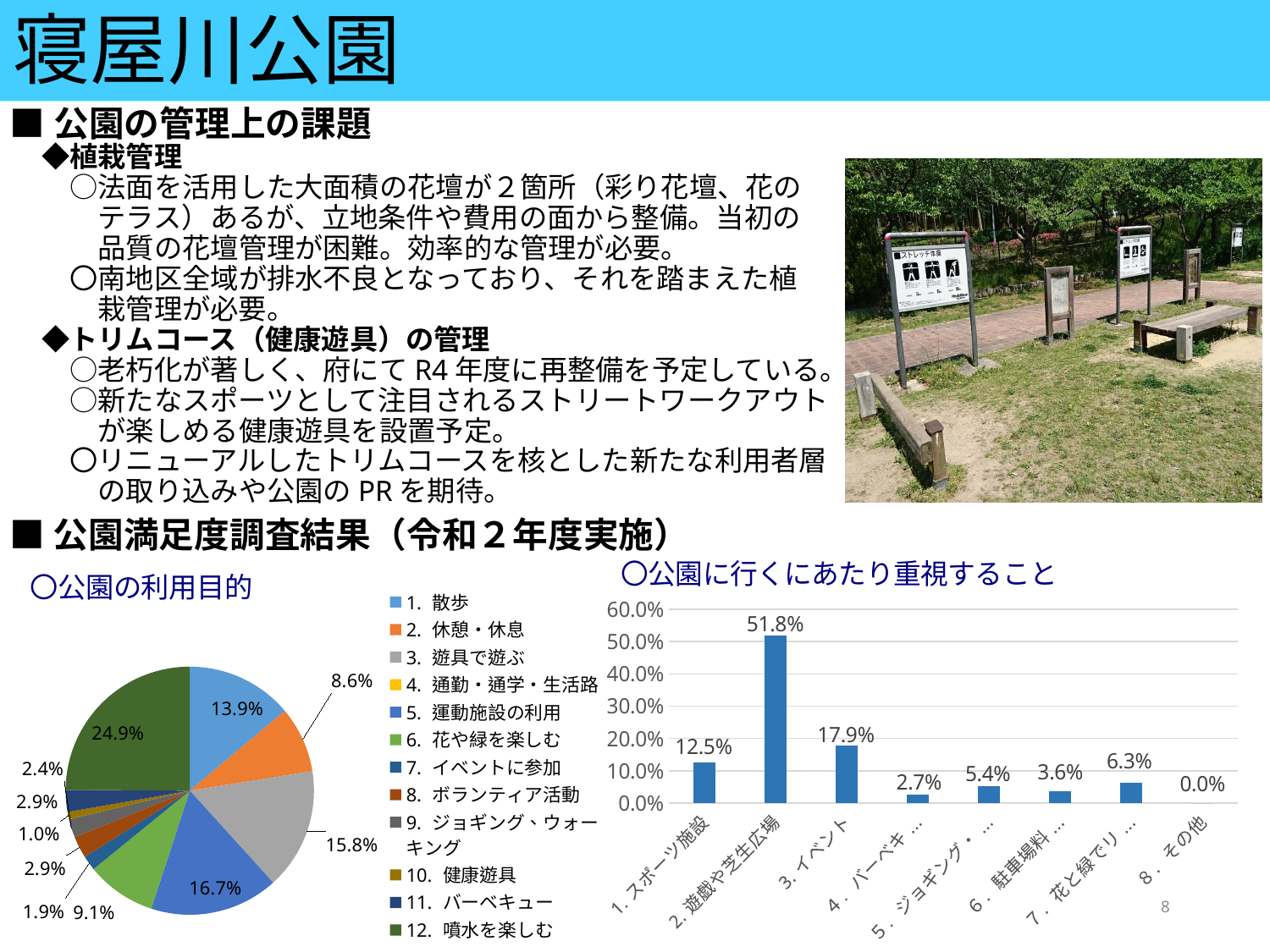
What kind of chart is the chart titled 公園の利用目的? pie chart In the bar chart titled 公園に行くにあたり重視すること, what is the difference between the values for 2. 遊戯や芝生広場 and 3. イベント? 33.9% In the pie chart titled 公園の利用目的, which is larger, the slice for 1. 散歩 or the slice for 2. 休憩・休息? 1. 散歩 How many entries does the legend of the pie chart titled 公園の利用目的 list? 12 In the bar chart titled 公園に行くにあたり重視すること, which category has the highest value? 2. 遊戯や芝生広場 In the bar chart titled 公園に行くにあたり重視すること, what is the value for 1. スポーツ施設? 12.5% In the bar chart titled 公園に行くにあたり重視すること, which category has the lowest value? 8. その他 In the pie chart titled 公園の利用目的, what is the share for 5. 運動施設の利用? 16.7% In the bar chart titled 公園に行くにあたり重視すること, what is the value for 3. イベント? 17.9% In the bar chart titled 公園に行くにあたり重視すること, what is the value for 2. 遊戯や芝生広場? 51.8% In the bar chart titled 公園に行くにあたり重視すること, is the value for 1. スポーツ施設 greater or less than 10.0%? greater In the bar chart titled 公園に行くにあたり重視すること, how many categories are shown on the x axis? 8